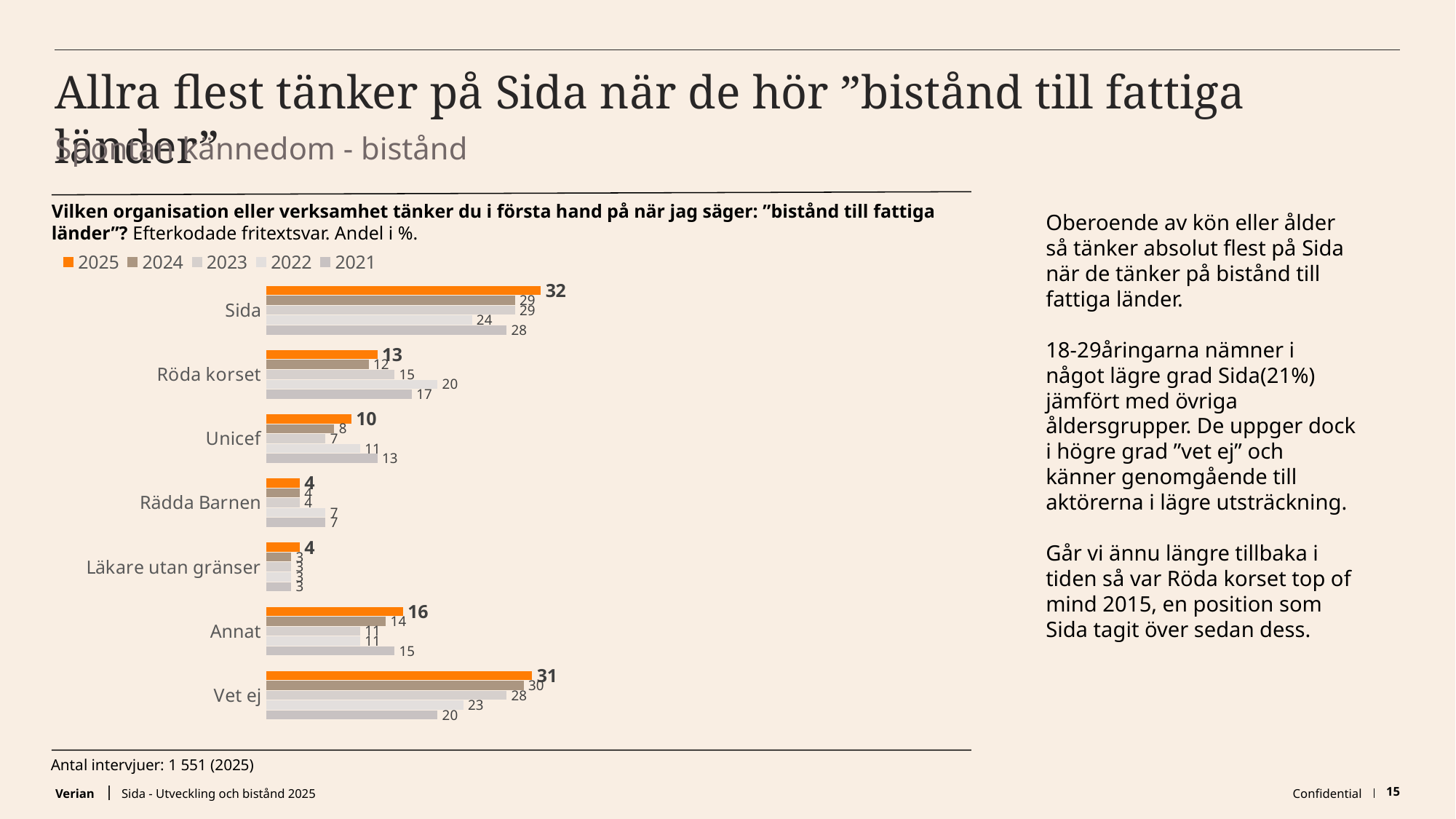
Which is larger for Röda korset: the 2025 value or the 2022 value? 2022 What is the 2021 value for Unicef? 13 Which category has the lowest 2021 value? Läkare utan gränser What is the 2025 value for Vet ej? 31 What is the difference between the 2025 and 2024 values for Sida? 3 How many categories are shown on the chart? 7 What kind of chart is shown on the slide? Bar chart Which category has the highest 2025 value? Sida How many series does the legend list? 5 Which colour represents the 2025 series in the legend? Orange What is the 2025 value for Sida? 32 What is the 2022 value for Röda korset? 20